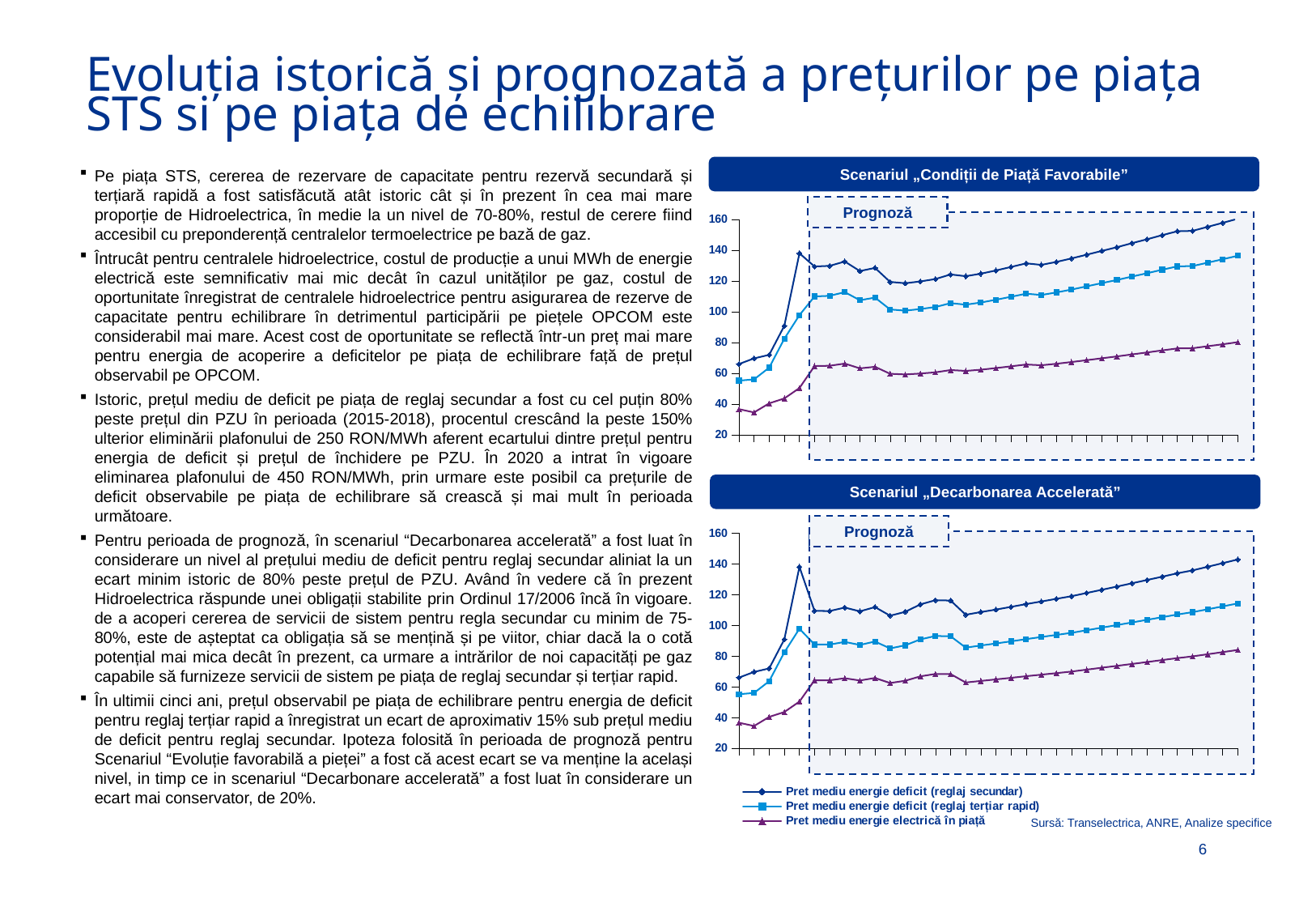
In the top chart (Condiții de Piață Favorabile), is the final value of "Pret mediu energie electrică în piață" greater or less than 100? less In the top chart (Condiții de Piață Favorabile), is the final value of "Pret mediu energie deficit (reglaj secundar)" greater or less than 140? greater In the bottom chart (Decarbonarea Accelerată), is the final value of "Pret mediu energie deficit (reglaj terțiar rapid)" greater or less than 100? greater In the top chart (Condiții de Piață Favorabile), do the values of "Pret mediu energie deficit (reglaj secundar)" rise or fall across the Prognoză period? rise In the bottom chart (Decarbonarea Accelerată), at the right end of the chart, which is larger: "Pret mediu energie deficit (reglaj terțiar rapid)" or "Pret mediu energie electrică în piață"? Pret mediu energie deficit (reglaj terțiar rapid) What is the title of the lower chart on the slide? Scenariul „Decarbonarea Accelerată” In the bottom chart (Decarbonarea Accelerată), which series has the lowest values across the chart? Pret mediu energie electrică în piață In the top chart (Condiții de Piață Favorabile), which series has the highest value at the right end of the chart? Pret mediu energie deficit (reglaj secundar) How many series does the legend at the bottom of the slide list? 3 Which series is plotted with triangle markers in the charts? Pret mediu energie electrică în piață What kind of chart is the top chart titled "Scenariul „Condiții de Piață Favorabile”"? line chart